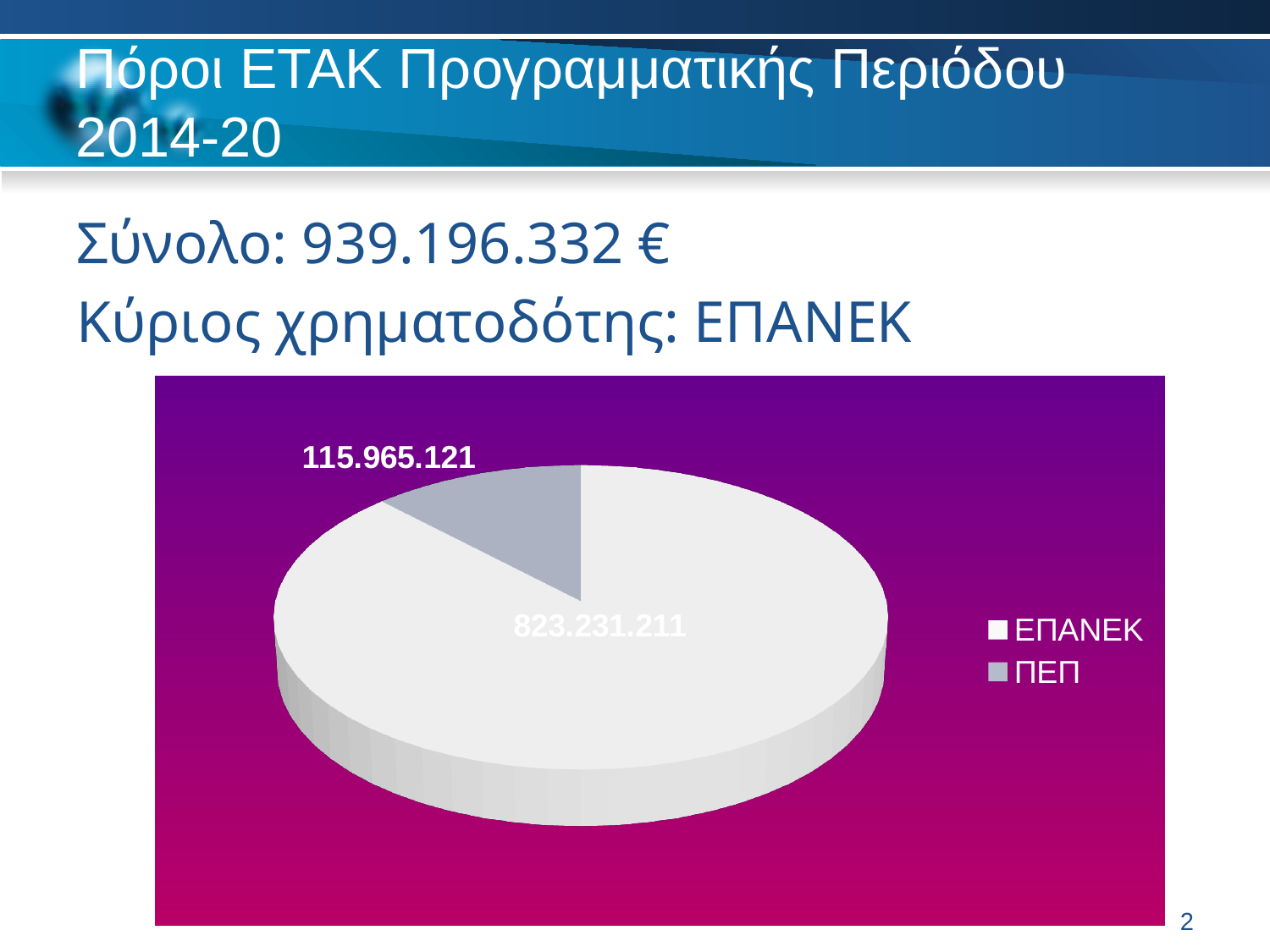
Which category has the smallest slice in the pie chart? ΠΕΠ What is the difference between the ΕΠΑΝΕΚ value and the ΠΕΠ value? 707.266.090 What is the value of the ΠΕΠ slice in the pie chart? 115.965.121 What share of the pie does the ΠΕΠ slice represent, to one decimal place? 12.3% What is the total of the two slices in the pie chart? 939.196.332 Which legend entry is shown in grey in the pie chart? ΠΕΠ How many entries does the legend of the pie chart list? 2 What is the value of the ΕΠΑΝΕΚ slice in the pie chart? 823.231.211 Which category has the largest slice in the pie chart? ΕΠΑΝΕΚ What kind of chart is shown on the slide? pie chart Which is larger, the ΕΠΑΝΕΚ slice or the ΠΕΠ slice? ΕΠΑΝΕΚ How many slices does the pie chart have? 2